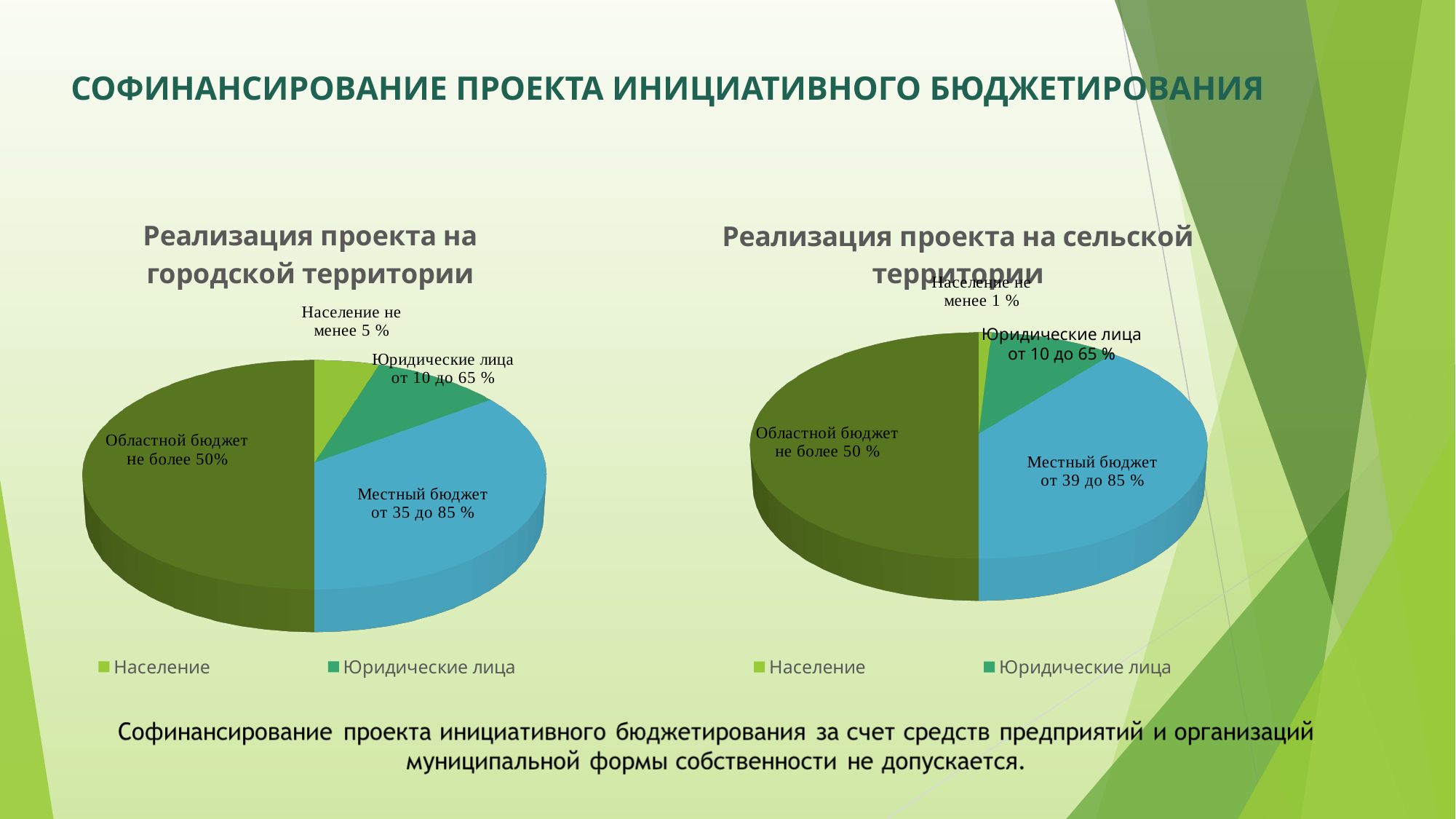
How many slices does the pie chart "Реализация проекта на городской территории" have? 4 In the chart "Реализация проекта на сельской территории", what range is labelled for Местный бюджет? от 39 до 85 % In the chart "Реализация проекта на сельской территории", which slice is the smallest? Население How many entries does the legend of the chart "Реализация проекта на сельской территории" list? 2 In the chart "Реализация проекта на сельской территории", what share is labelled for Население? не менее 1 % In the chart "Реализация проекта на сельской территории", what range is labelled for Юридические лица? от 10 до 65 % In the chart "Реализация проекта на городской территории", which slice is the largest? Областной бюджет In the chart "Реализация проекта на городской территории", what range is labelled for Местный бюджет? от 35 до 85 % What kind of chart is used for "Реализация проекта на городской территории"? pie chart In the chart "Реализация проекта на городской территории", which slice is larger: Местный бюджет or Юридические лица? Местный бюджет In the chart "Реализация проекта на городской территории", what share is labelled for Население? не менее 5 % In the chart "Реализация проекта на городской территории", what limit is labelled for Областной бюджет? не более 50%